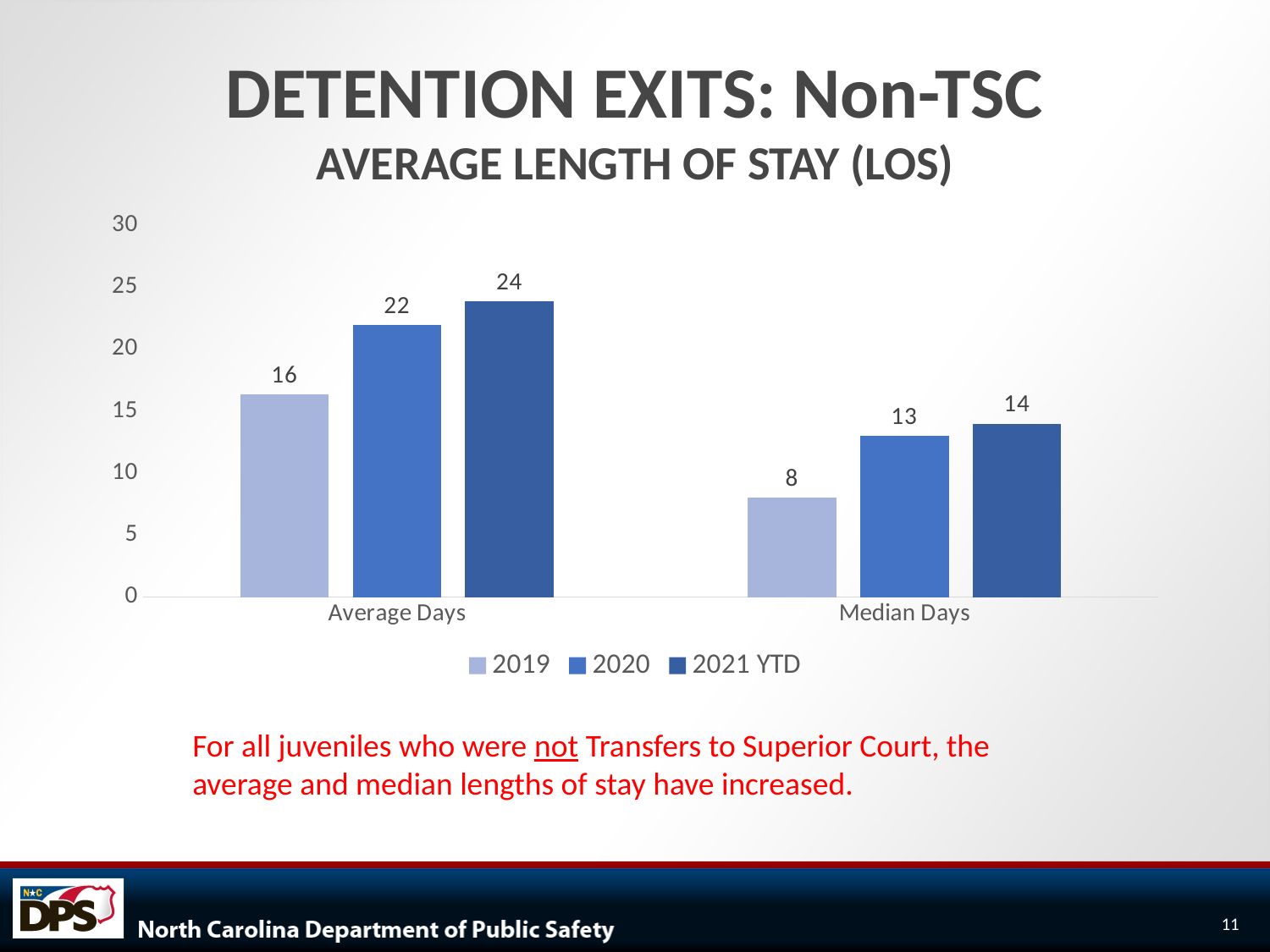
Which is larger: the 2020 value for Average Days or the 2020 value for Median Days? Average Days What is the value for 2019 in the Average Days category? 16 What is the value for 2021 YTD in the Median Days category? 14 Do the values for Median Days rise or fall from 2019 to 2021 YTD? rise What is the difference between the 2021 YTD and 2019 values for Average Days? 8 Which series has the lowest value in the Median Days category? 2019 How many series does the legend list? 3 What kind of chart is shown on the slide? bar chart What is the value for 2020 in the Median Days category? 13 Which series has the highest value in the Average Days category? 2021 YTD Is the 2019 value for Median Days greater or less than 10? less What is the difference between the 2020 and 2019 values for Median Days? 5